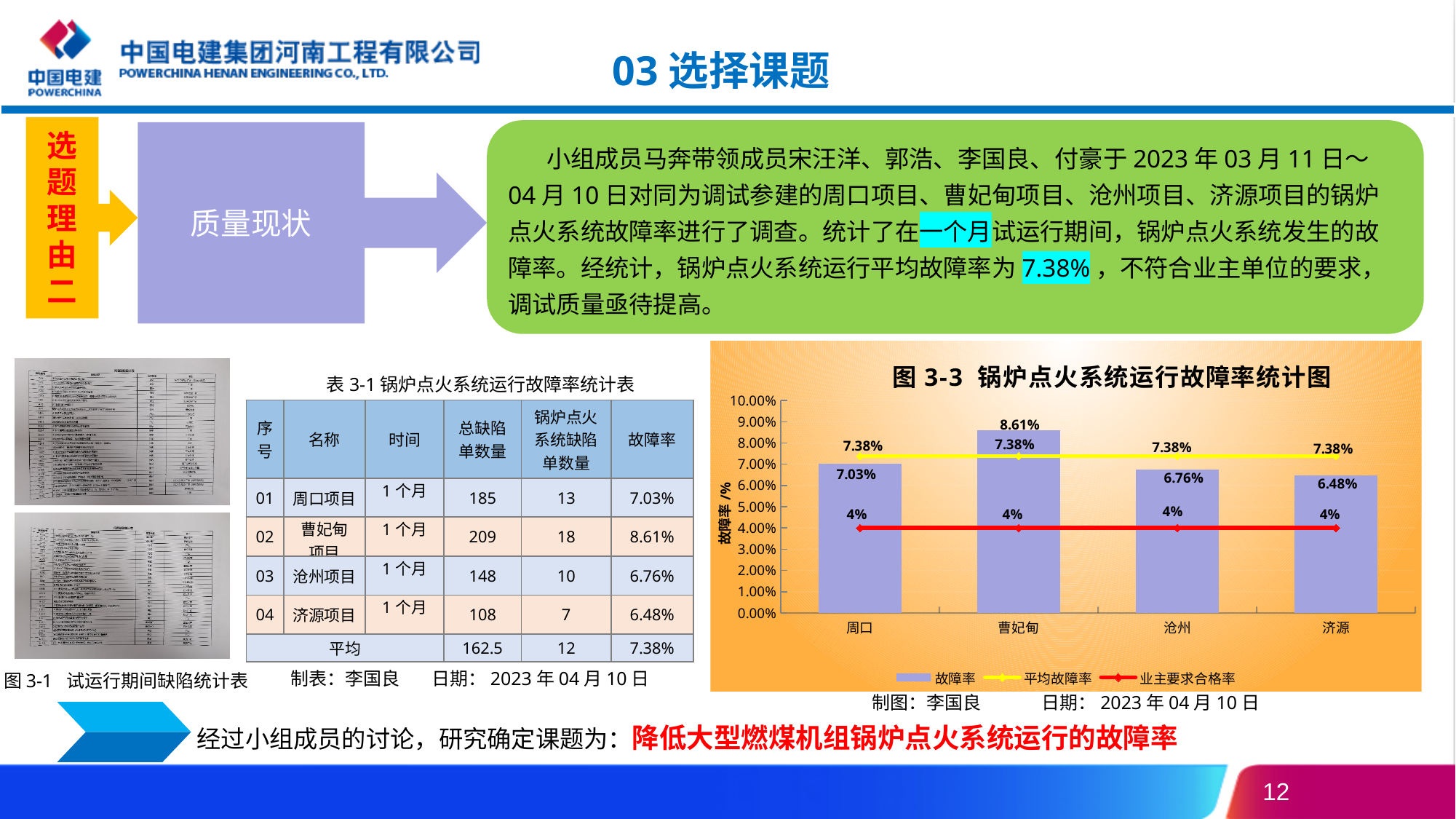
Which project has the lowest 故障率 in the chart 图 3-3? 济源 What value does the 平均故障率 line show in the chart 图 3-3? 7.38% In the chart 图 3-3, which is larger, the 故障率 of 周口 or of 沧州? 周口 What is the 故障率 value for 济源 in the chart 图 3-3? 6.48% What type of chart is 图 3-3? Bar chart with line series Which project has the highest 故障率 in the chart 图 3-3? 曹妃甸 How many series does the legend of the chart 图 3-3 list? 3 What value does the 业主要求合格率 line show in the chart 图 3-3? 4% What is the 故障率 value for 周口 in the chart 图 3-3? 7.03% What is the difference between the 故障率 of 曹妃甸 and 沧州 in the chart 图 3-3? 1.85% What is the 故障率 value for 曹妃甸 in the chart 图 3-3? 8.61% How many projects are shown on the x axis of the chart 图 3-3? 4